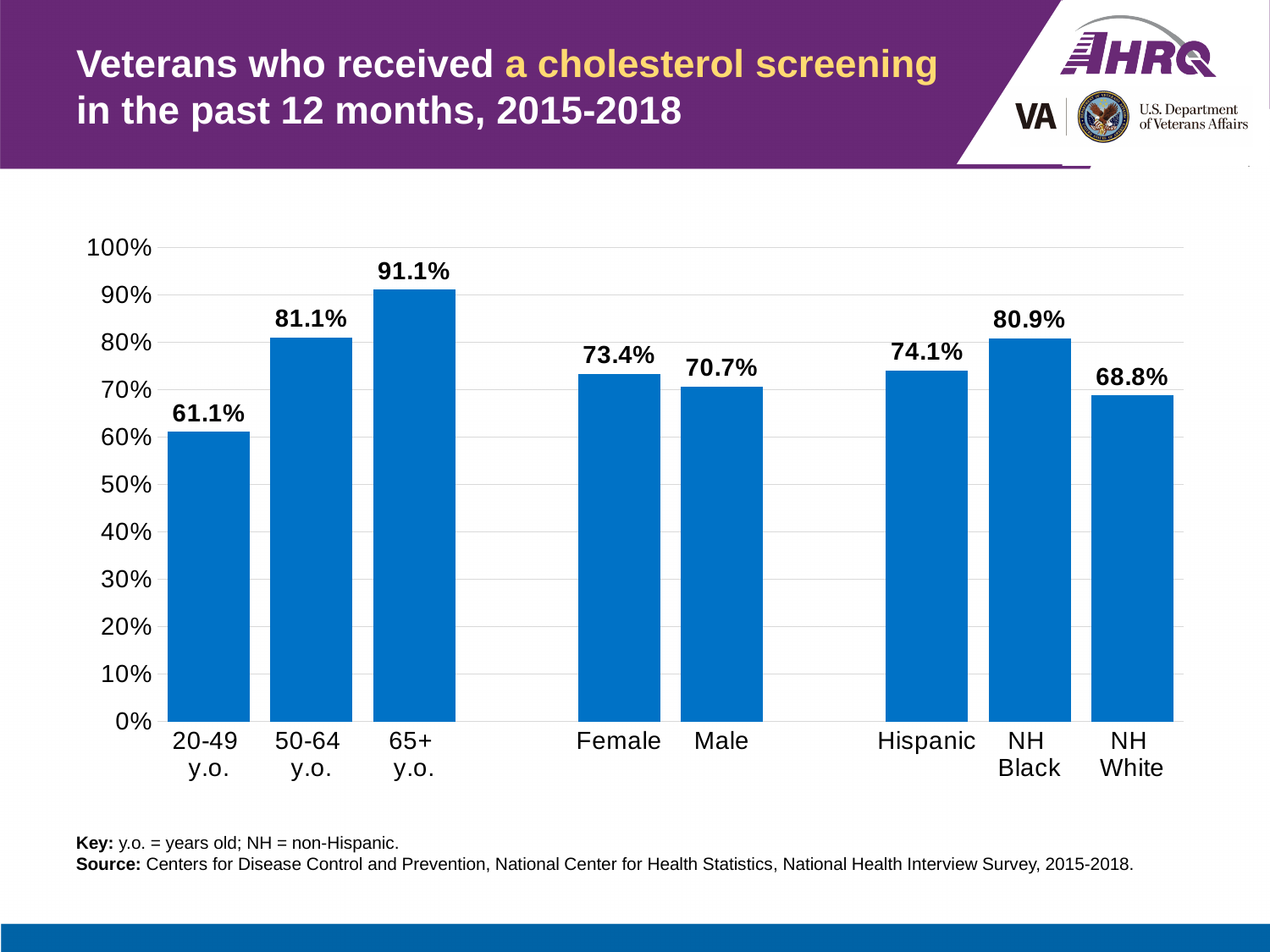
What percentage of veterans aged 65+ y.o. received a cholesterol screening in the past 12 months? 91.1% What is the value shown for Female veterans? 73.4% Which is larger, the value for Hispanic veterans or the value for NH White veterans? Hispanic How many categories are shown on the x axis of the chart? 8 Do the values rise or fall across the three age groups from 20-49 y.o. to 65+ y.o.? Rise What is the value shown for NH Black veterans? 80.9% Is the value for 50-64 y.o. veterans greater or less than 80%? greater What is the difference in percentage points between Female and Male veterans? 2.7 What is the difference in percentage points between NH Black and NH White veterans? 12.1 Which category has the lowest percentage of veterans receiving a cholesterol screening? 20-49 y.o. Which category has the highest percentage of veterans receiving a cholesterol screening? 65+ y.o. What kind of chart is shown on the slide? Bar chart